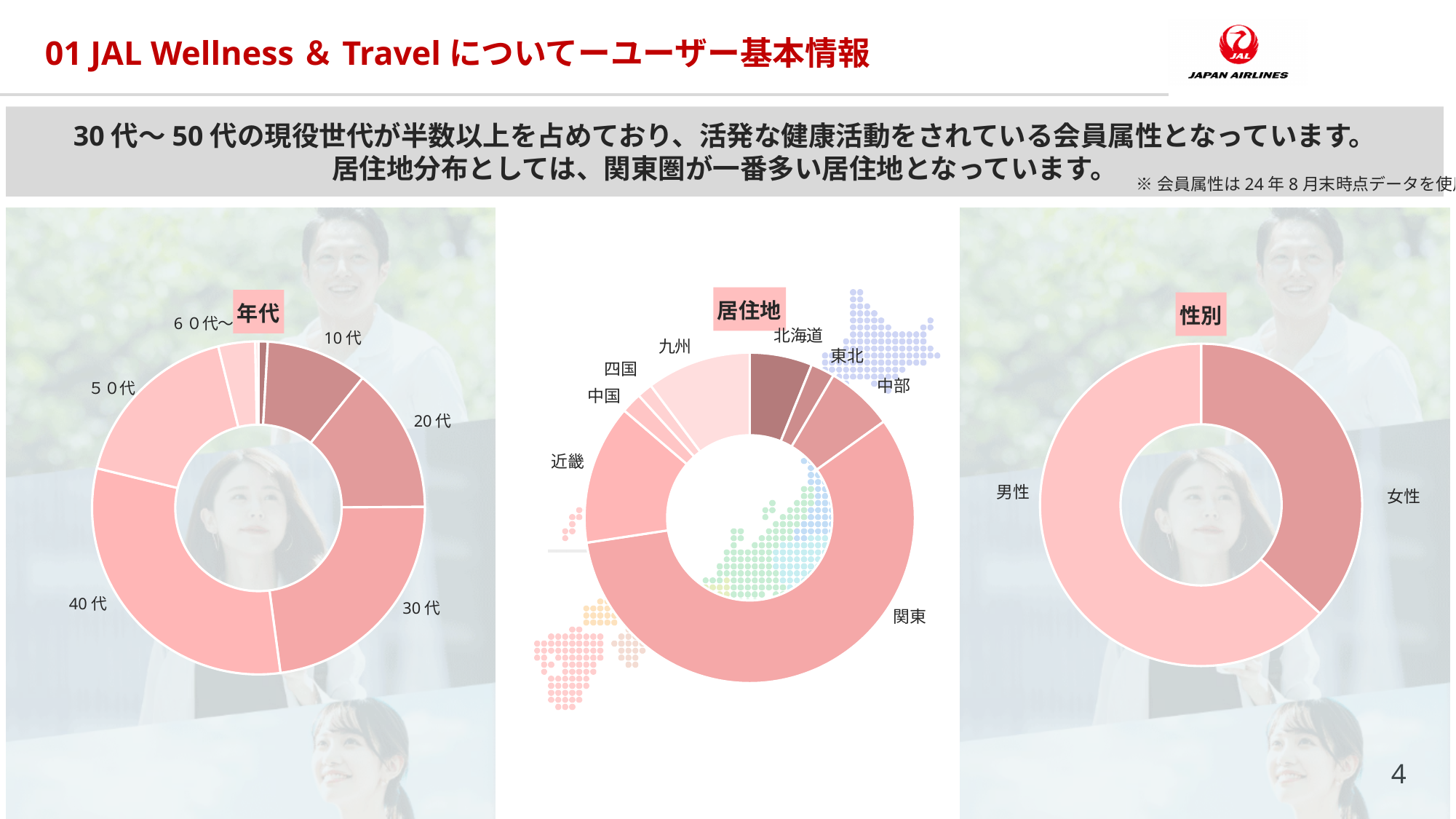
In the 居住地 chart, which is larger, 東北 or 中部? 中部 In the 居住地 chart, which region has the largest share? 関東 In the 年代 chart, which is larger, 10代 or 20代? 20代 How many regions does the 居住地 chart show? 8 In the 居住地 chart, which is larger, 近畿 or 九州? 近畿 How many charts are shown on the slide? 3 How many age categories does the 年代 chart show? 6 In the 年代 chart, which age group has the smallest share? 60代〜 How many categories does the 性別 chart on the right show? 2 In the 年代 chart, which age group has the largest share? 40代 What kind of chart is the 年代 chart on the left? Donut (pie) chart